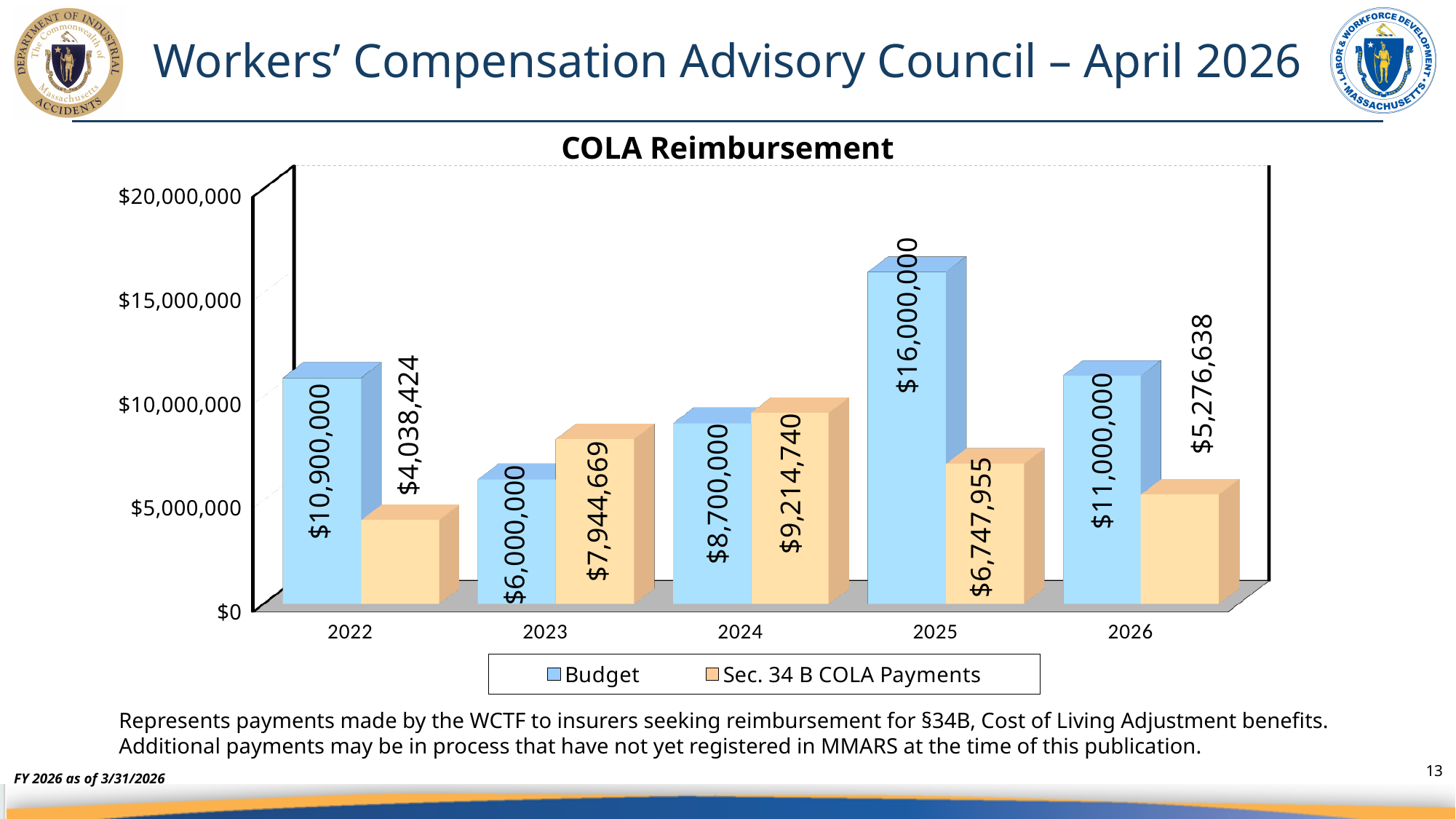
What is the Sec. 34 B COLA Payments value for 2024? $9,214,740 Which year has the lowest Sec. 34 B COLA Payments value? 2022 How many series does the legend list? 2 Which year has the highest Sec. 34 B COLA Payments value? 2024 What is the Budget value for 2025 in the COLA Reimbursement chart? $16,000,000 What is the Sec. 34 B COLA Payments value for 2022? $4,038,424 In 2024, which is larger: the Budget or the Sec. 34 B COLA Payments? Sec. 34 B COLA Payments What is the Budget value for 2023? $6,000,000 How many years are shown on the x axis of the COLA Reimbursement chart? 5 What is the difference between the Budget and the Sec. 34 B COLA Payments in 2025? $9,252,045 What kind of chart is the COLA Reimbursement chart? Bar chart Which year has the highest Budget value? 2025